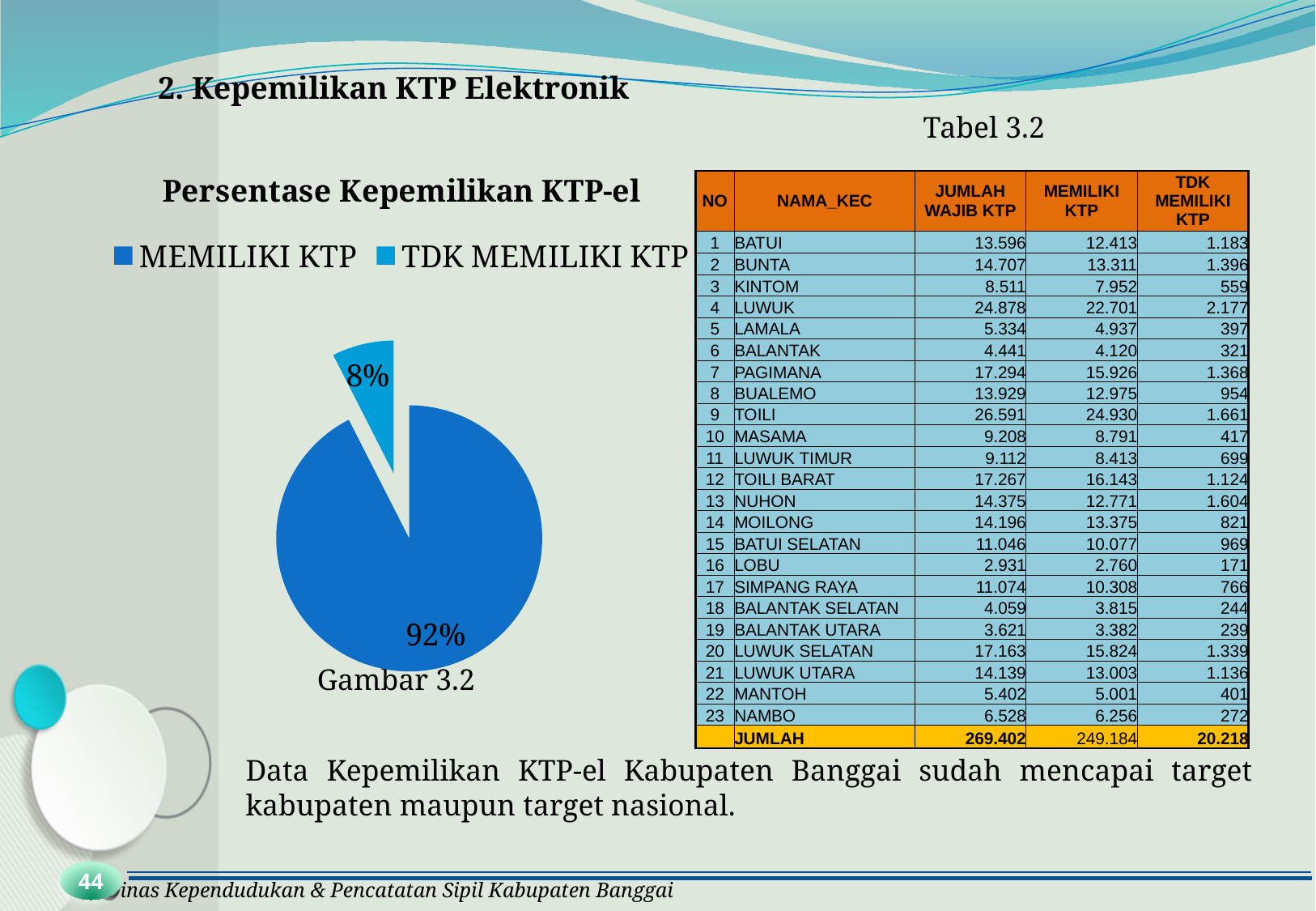
What figure label is given below the pie chart? Gambar 3.2 How many entries does the legend of the pie chart list? 2 Which slice of the pie chart is the smallest? TDK MEMILIKI KTP Is the share for TDK MEMILIKI KTP greater or less than 10%? less How many slices does the pie chart have? 2 Which slice of the pie chart is the largest? MEMILIKI KTP What share of the pie does MEMILIKI KTP represent? 92% Which is larger in the pie chart, MEMILIKI KTP or TDK MEMILIKI KTP? MEMILIKI KTP What kind of chart is shown on the slide? pie chart What is the title of the pie chart? Persentase Kepemilikan KTP-el What is the difference in percentage points between the MEMILIKI KTP slice and the TDK MEMILIKI KTP slice? 84 What share of the pie does TDK MEMILIKI KTP represent? 8%